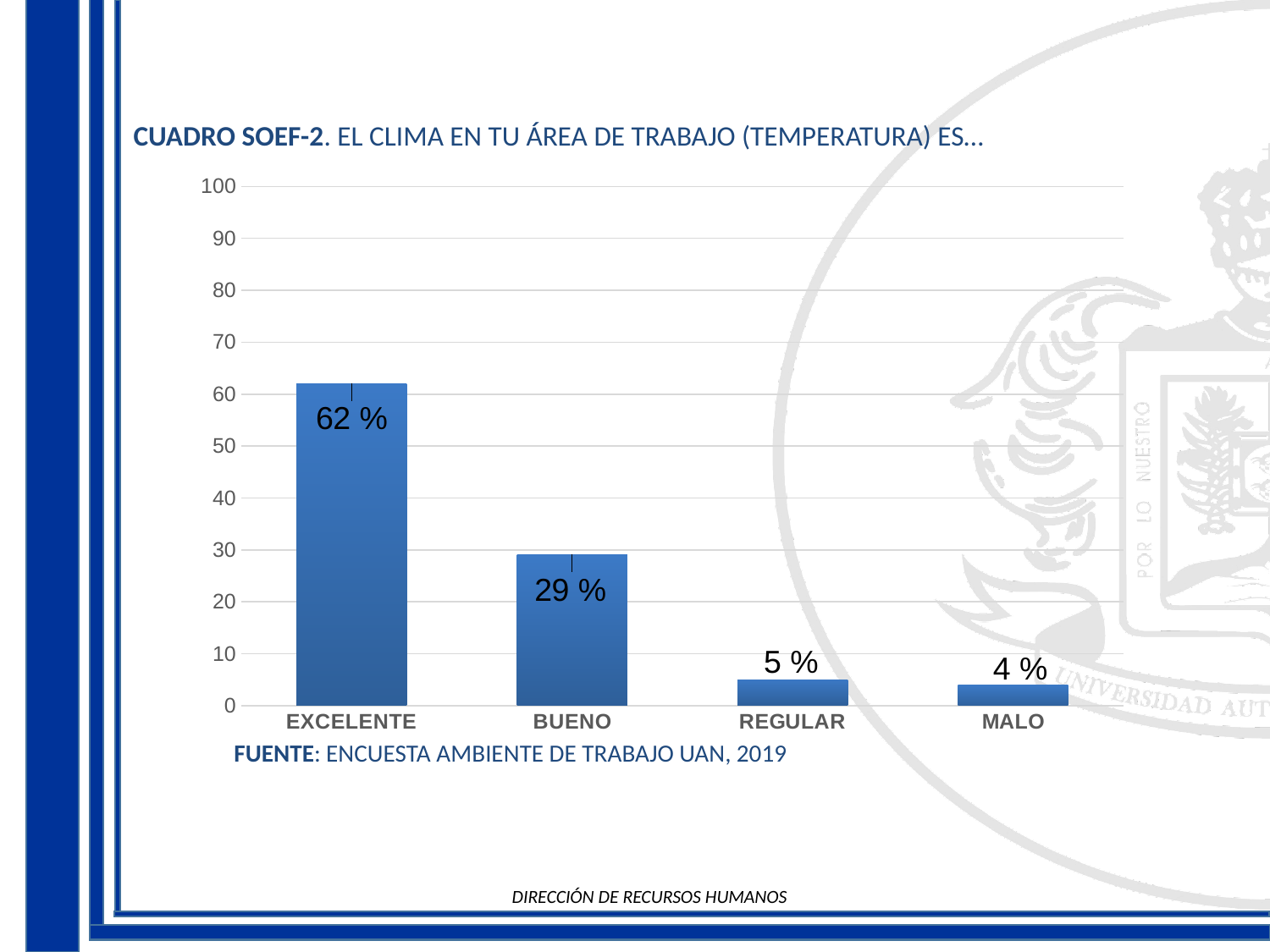
Which category has the highest value? EXCELENTE What is the value for REGULAR? 5 % What is the value for BUENO? 29 % Which is larger, the value for BUENO or the value for REGULAR? BUENO What kind of chart is shown on the slide? bar chart How many categories are shown on the x axis? 4 What is the difference between the values for EXCELENTE and BUENO? 33 % What is the value for EXCELENTE? 62 % Which category has the lowest value? MALO Do the values rise or fall from left to right along the x axis? fall What is the value for MALO? 4 % Is the value for EXCELENTE greater or less than 50? greater